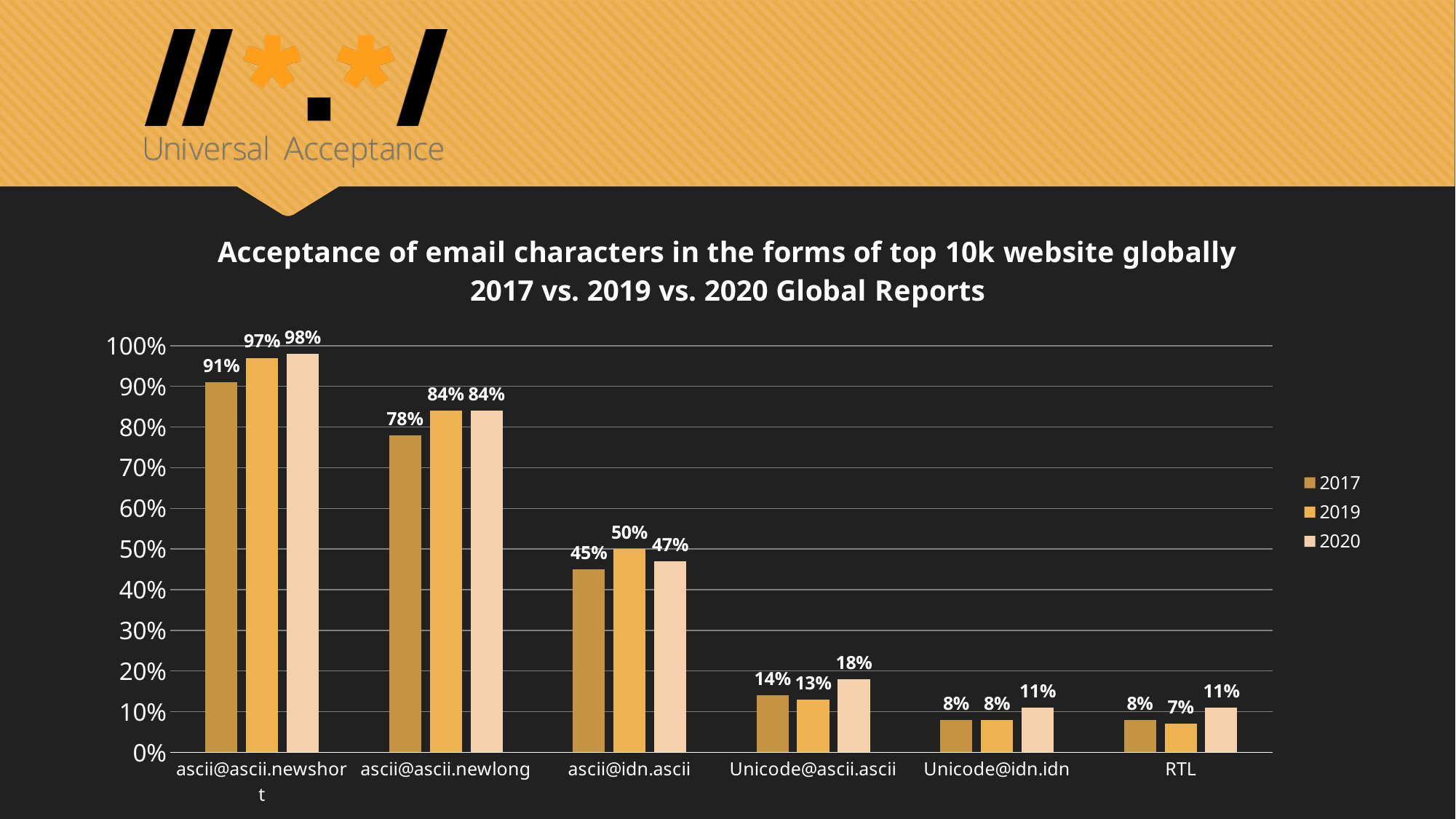
What is the 2019 value for ascii@idn.ascii? 50% What is the 2019 value for RTL? 7% What is the 2020 value for ascii@ascii.newshort? 98% What kind of chart is shown on the slide? Bar chart Which category has the highest 2020 value? ascii@ascii.newshort How many categories are shown on the x axis? 6 How many series does the legend list? 3 What is the 2017 value for ascii@ascii.newlong? 78% Which is larger for Unicode@ascii.ascii: the 2017 value or the 2019 value? 2017 What is the 2020 value for Unicode@ascii.ascii? 18% Which category has the lowest 2019 value? RTL What is the difference between the 2020 and 2017 values for ascii@ascii.newshort? 7%